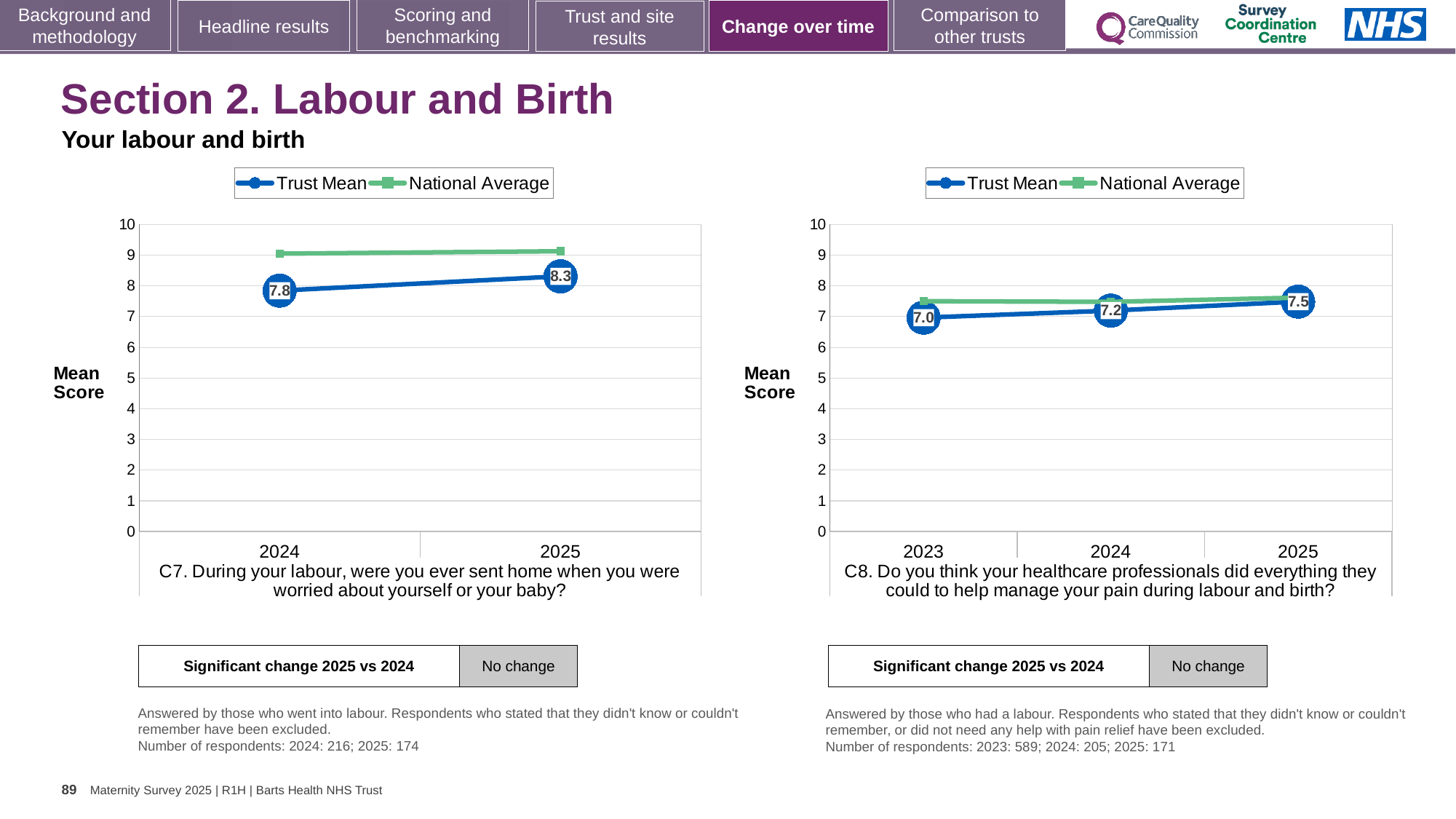
In the C8 chart on the right, does the Trust Mean rise or fall from 2023 to 2025? rise How many series does the legend of the C8 chart on the right list? 2 In the C8 chart on the right, which year has the lowest Trust Mean? 2023 In the C8 chart on the right, which year has the highest Trust Mean? 2025 In the C7 chart on the left, is the National Average for 2024 greater or less than 8? greater In the C8 chart on the right, what is the Trust Mean for 2023? 7.0 In the C7 chart on the left, what is the Trust Mean for 2025? 8.3 In the C7 chart on the left, what is the Trust Mean for 2024? 7.8 In the C7 chart on the left, by how much did the Trust Mean change from 2024 to 2025? 0.5 In the C8 chart on the right, what is the difference between the Trust Mean in 2025 and in 2023? 0.5 In the C7 chart on the left, which is larger in 2025, the Trust Mean or the National Average? National Average In the C8 chart on the right, what is the Trust Mean for 2025? 7.5